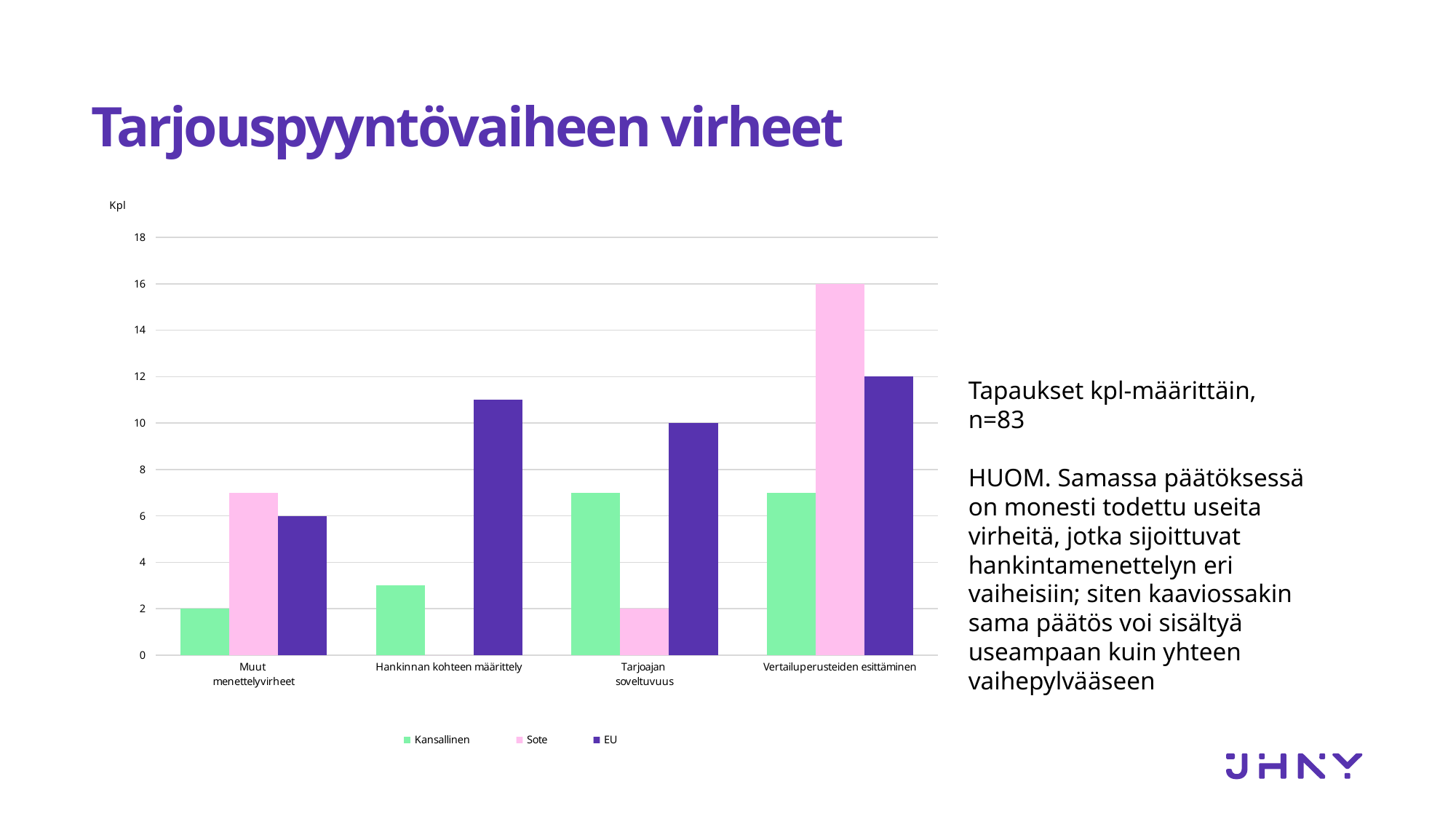
What is the difference between the Sote and EU values in the Vertailuperusteiden esittäminen category? 4 What kind of chart is shown on the slide? bar chart How many categories are shown on the x axis? 4 Is the value for Sote in the Muut menettelyvirheet category greater or less than 6? greater What is the value for Kansallinen in the Muut menettelyvirheet category? 2 Which category has the lowest EU value? Muut menettelyvirheet In the Hankinnan kohteen määrittely category, which series has the larger value, Kansallinen or EU? EU What is the value for EU in the Muut menettelyvirheet category? 6 How many series does the legend list? 3 Which category has the highest Sote value? Vertailuperusteiden esittäminen What is the value for EU in the Tarjoajan soveltuvuus category? 10 What is the value for Sote in the Vertailuperusteiden esittäminen category? 16